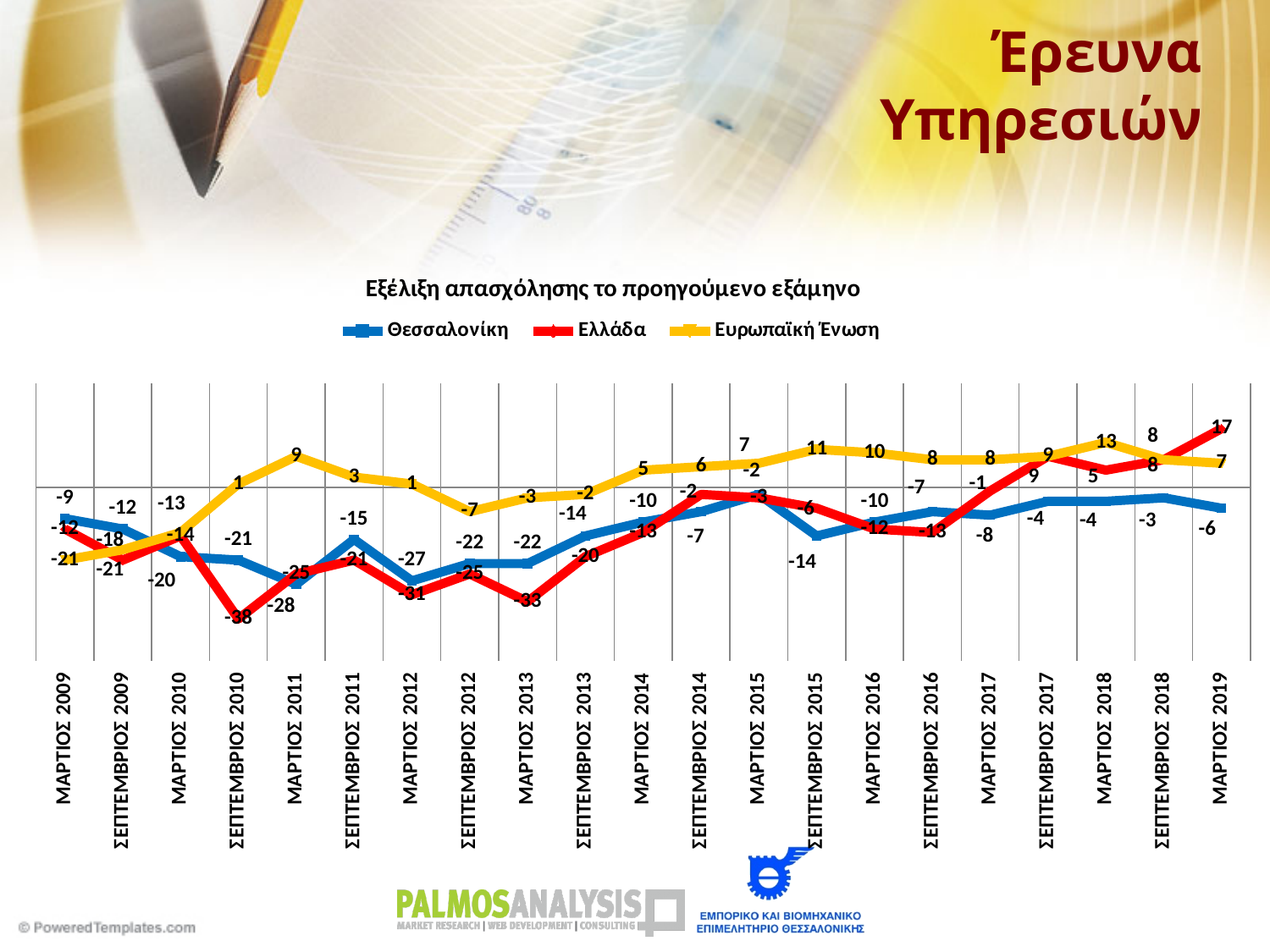
What kind of chart is shown on the slide? line chart How many series does the legend list? 3 What is the value for Ελλάδα in ΣΕΠΤΕΜΒΡΙΟΣ 2010? -38 What is the value for Ελλάδα in ΜΑΡΤΙΟΣ 2019? 17 In ΜΑΡΤΙΟΣ 2019, which is larger: the value for Ελλάδα or for Ευρωπαϊκή Ένωση? Ελλάδα What is the value for Ευρωπαϊκή Ένωση in ΜΑΡΤΙΟΣ 2018? 13 In which period does the Ευρωπαϊκή Ένωση series reach its highest value? ΜΑΡΤΙΟΣ 2018 What is the title of the chart? Εξέλιξη απασχόλησης το προηγούμενο εξάμηνο How many time points are plotted along the x axis? 21 In which period does the Ελλάδα series reach its lowest value? ΣΕΠΤΕΜΒΡΙΟΣ 2010 What is the value for Ευρωπαϊκή Ένωση in ΣΕΠΤΕΜΒΡΙΟΣ 2012? -7 What is the difference between the Ελλάδα value (17) and the Ευρωπαϊκή Ένωση value (7) in ΜΑΡΤΙΟΣ 2019? 10